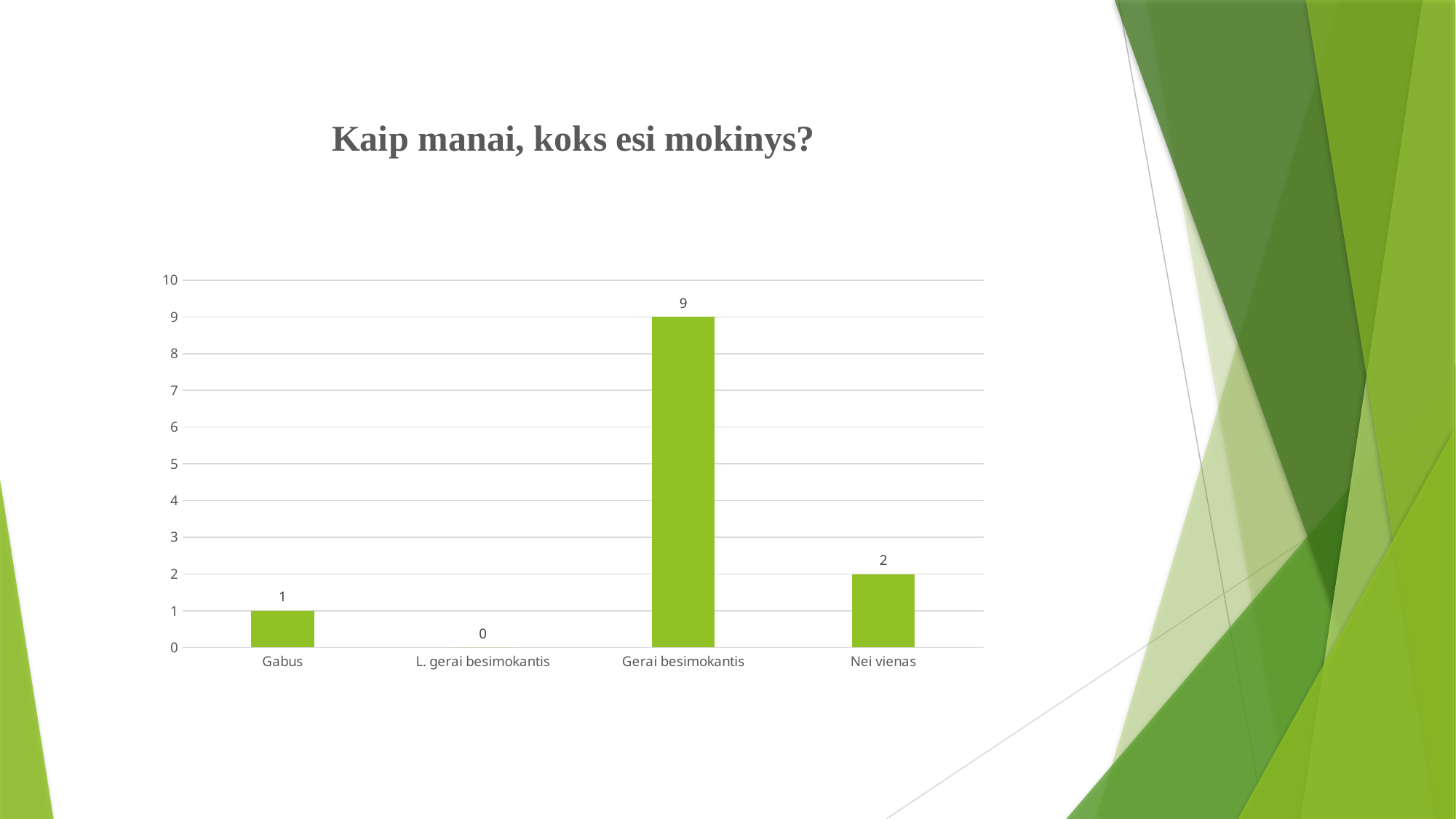
What is the value for Nei vienas? 2 Which category has the highest value? Gerai besimokantis How many categories are shown on the x axis? 4 What is the value for L. gerai besimokantis? 0 What is the difference between the values for Gerai besimokantis and Nei vienas? 7 Which is larger, the value for Nei vienas or the value for Gabus? Nei vienas Is the value for Gerai besimokantis greater or less than 5? greater What is the value for Gabus? 1 What is the title of the slide above the chart? Kaip manai, koks esi mokinys? What is the value for Gerai besimokantis? 9 Which category has the lowest value? L. gerai besimokantis What kind of chart is shown on the slide? bar chart